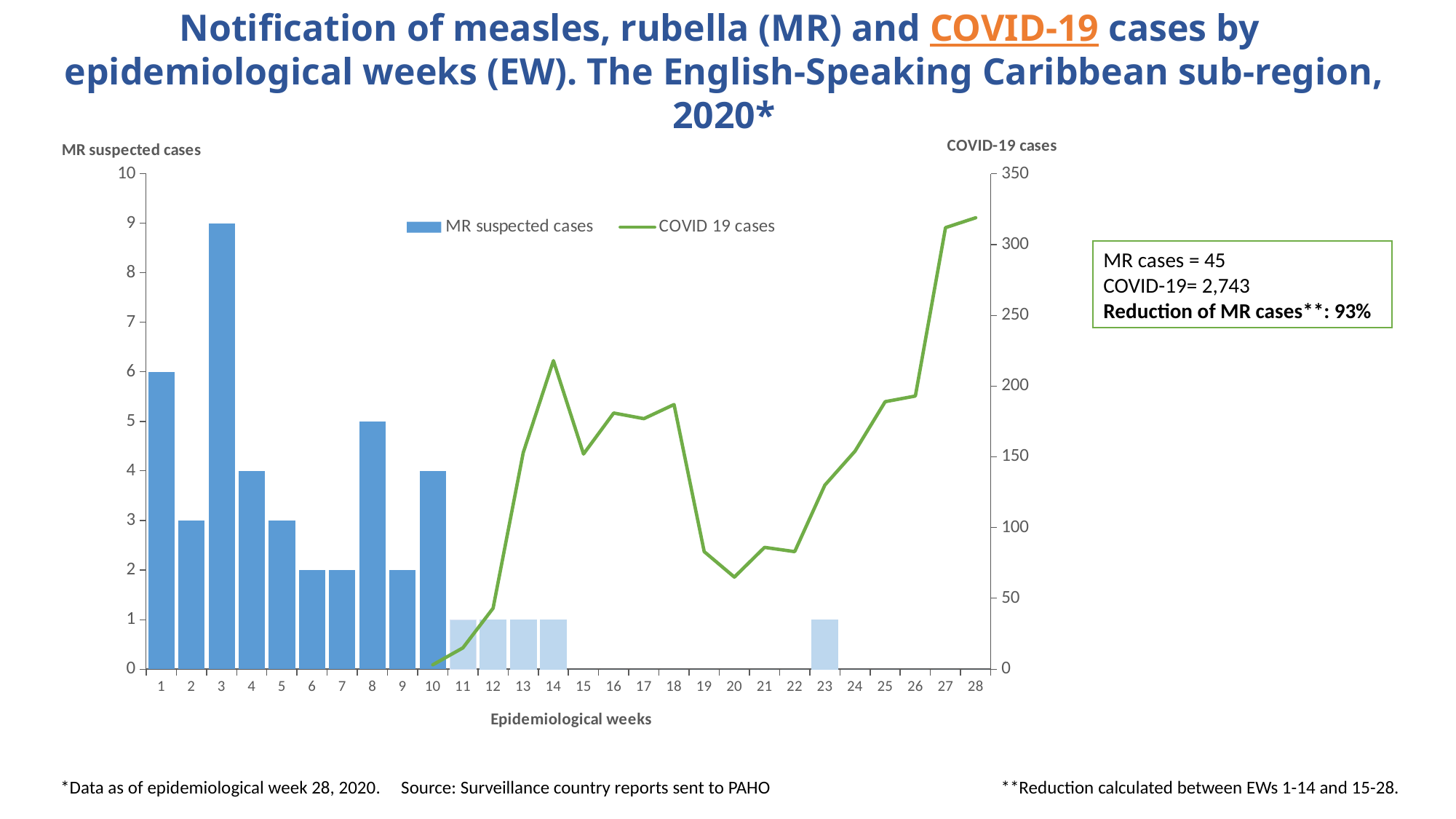
Do the COVID 19 cases rise or fall between epidemiological week 23 and week 28? rise What is the value of MR suspected cases in epidemiological week 3? 9 What is the difference in MR suspected cases between week 3 and week 1? 3 How many series does the legend list? 2 What is the value of MR suspected cases in epidemiological week 1? 6 Is the value of COVID 19 cases in epidemiological week 20 greater or less than 100? less How many epidemiological weeks are shown on the x axis? 28 Which has more MR suspected cases, week 4 or week 8? week 8 Which epidemiological week has the highest number of MR suspected cases? 3 What is the label of the right-hand vertical axis? COVID-19 cases What is the value of MR suspected cases in epidemiological week 8? 5 Is the value of COVID 19 cases in epidemiological week 28 greater or less than 300? greater